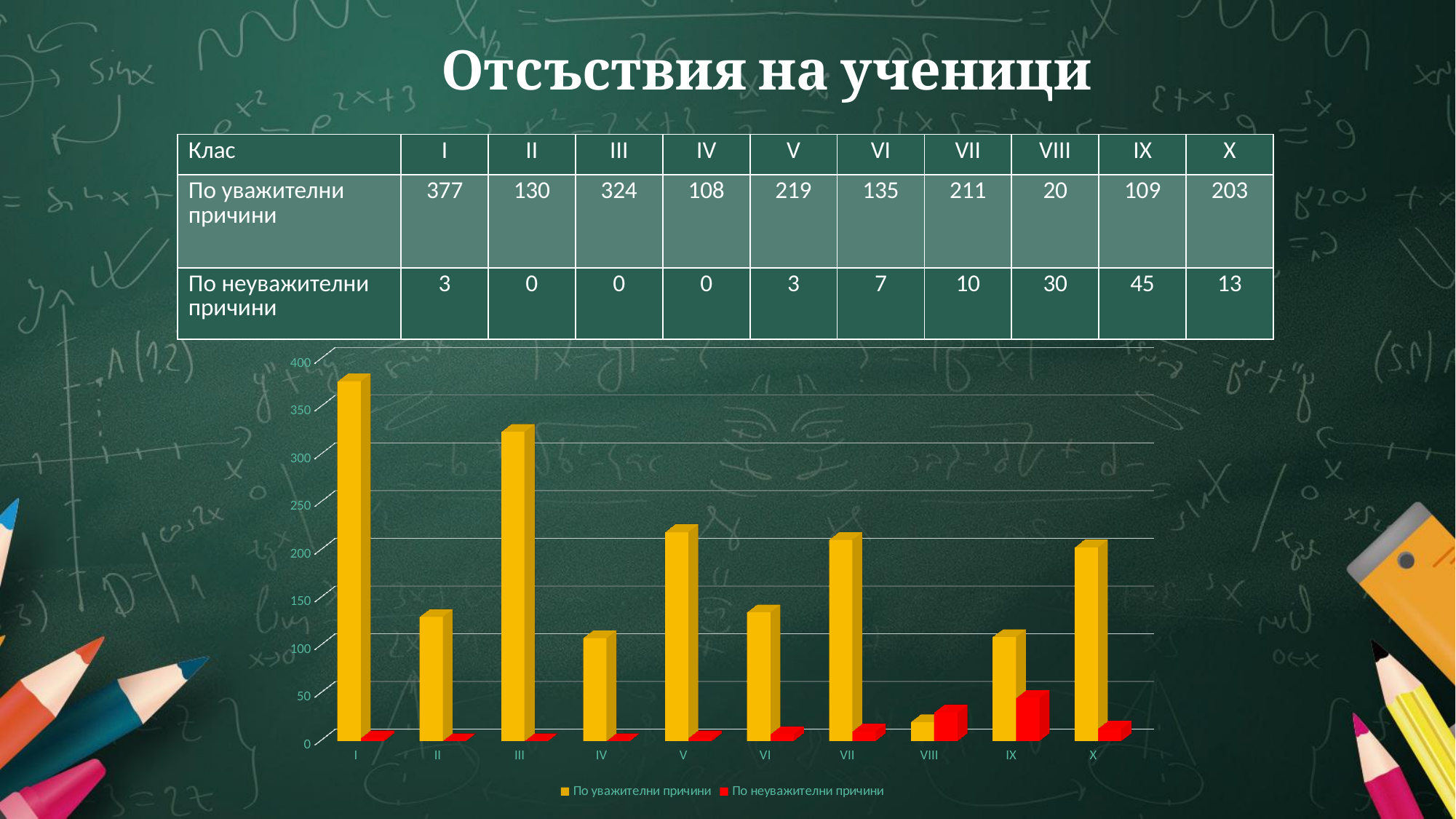
Which class has the lowest value for 'По уважителни причини'? VIII How many series does the chart legend list? 2 How many classes (categories) are shown on the x axis of the chart? 10 What kind of chart is shown on the slide? bar chart What colour are the bars for the series 'По неуважителни причини'? red What is the value for 'По неуважителни причини' for class VIII? 30 What is the difference between the 'По уважителни причини' values for class I and class III? 53 Which class has the highest value for 'По уважителни причини'? I Is the 'По уважителни причини' value for class V greater or less than 200? greater Which class has the highest value for 'По неуважителни причини'? IX Which is larger: the 'По уважителни причини' value for class VII or for class X? VII What is the value for 'По уважителни причини' for class III? 324